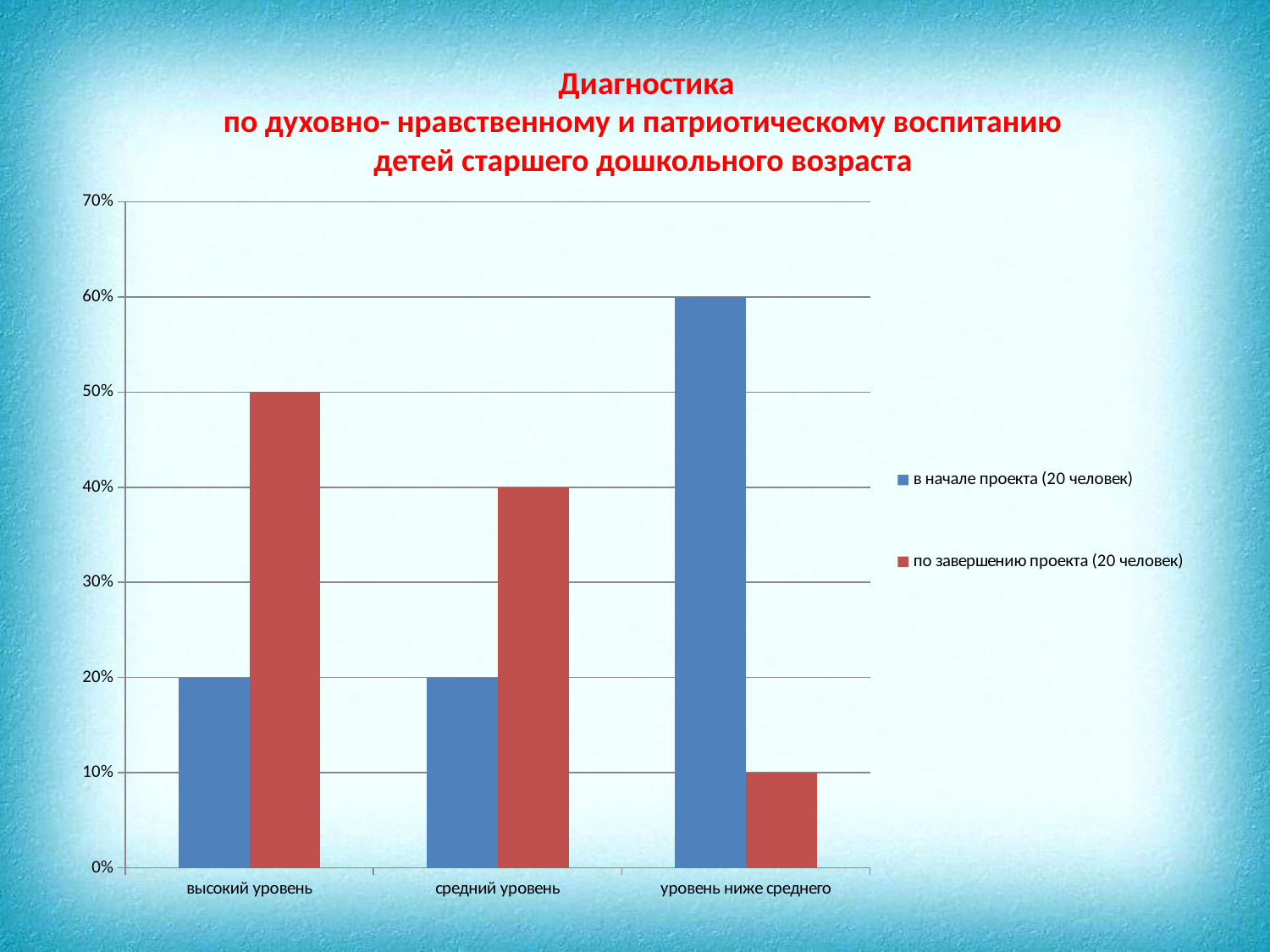
Which category has the highest value in the series 'в начале проекта (20 человек)'? уровень ниже среднего What is the value for 'высокий уровень' in the series 'в начале проекта (20 человек)'? 20% What is the value for 'высокий уровень' in the series 'по завершению проекта (20 человек)'? 50% How many series does the legend list? 2 How many categories are shown on the x axis? 3 For 'уровень ниже среднего', which series has the larger value: 'в начале проекта (20 человек)' or 'по завершению проекта (20 человек)'? в начале проекта (20 человек) What is the value for 'уровень ниже среднего' in the series 'по завершению проекта (20 человек)'? 10% What is the value for 'уровень ниже среднего' in the series 'в начале проекта (20 человек)'? 60% What kind of chart is shown on the slide? bar chart What is the difference between the 'по завершению проекта (20 человек)' and 'в начале проекта (20 человек)' values for 'средний уровень'? 20% What colour are the bars for the series 'по завершению проекта (20 человек)'? red Which category has the lowest value in the series 'по завершению проекта (20 человек)'? уровень ниже среднего